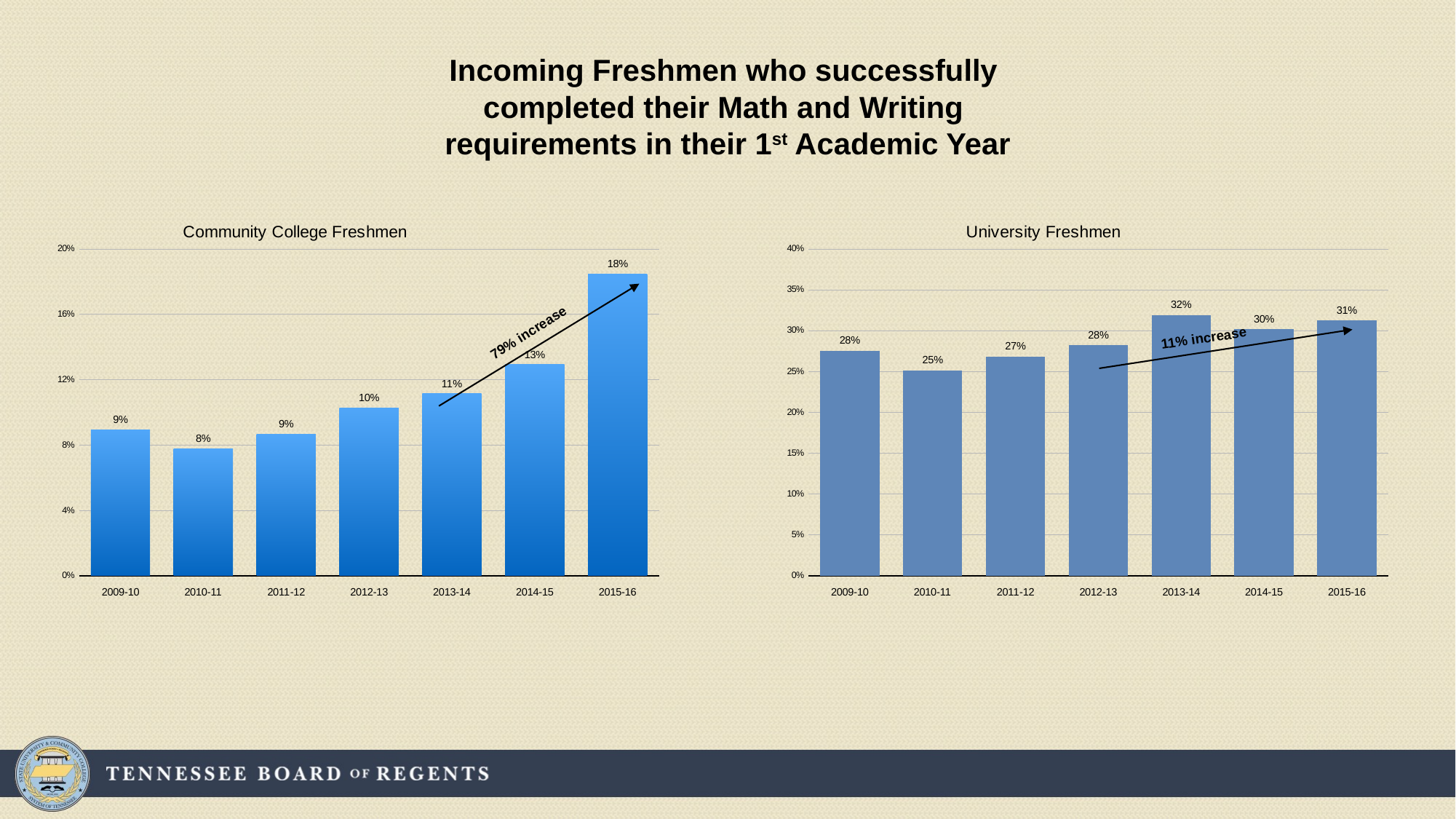
In the University Freshmen chart, which year has the highest value? 2013-14 In the Community College Freshmen chart, what is the difference between the 2015-16 value and the 2009-10 value? 9% How many years are shown on the x axis of the University Freshmen chart? 7 In the Community College Freshmen chart, which year has the lowest value? 2010-11 In the University Freshmen chart, what is the difference between the 2013-14 value and the 2010-11 value? 7% What percentage increase is annotated on the University Freshmen chart? 11% increase What kind of chart is the Community College Freshmen chart? Bar chart In the Community College Freshmen chart, do the values generally rise or fall from 2010-11 to 2015-16? Rise In the Community College Freshmen chart, is the value for 2014-15 greater or less than 12%? greater In the University Freshmen chart, which is larger, the value for 2011-12 or the value for 2014-15? 2014-15 In the University Freshmen chart, what is the value for 2010-11? 25% In the Community College Freshmen chart, what is the value for 2015-16? 18%